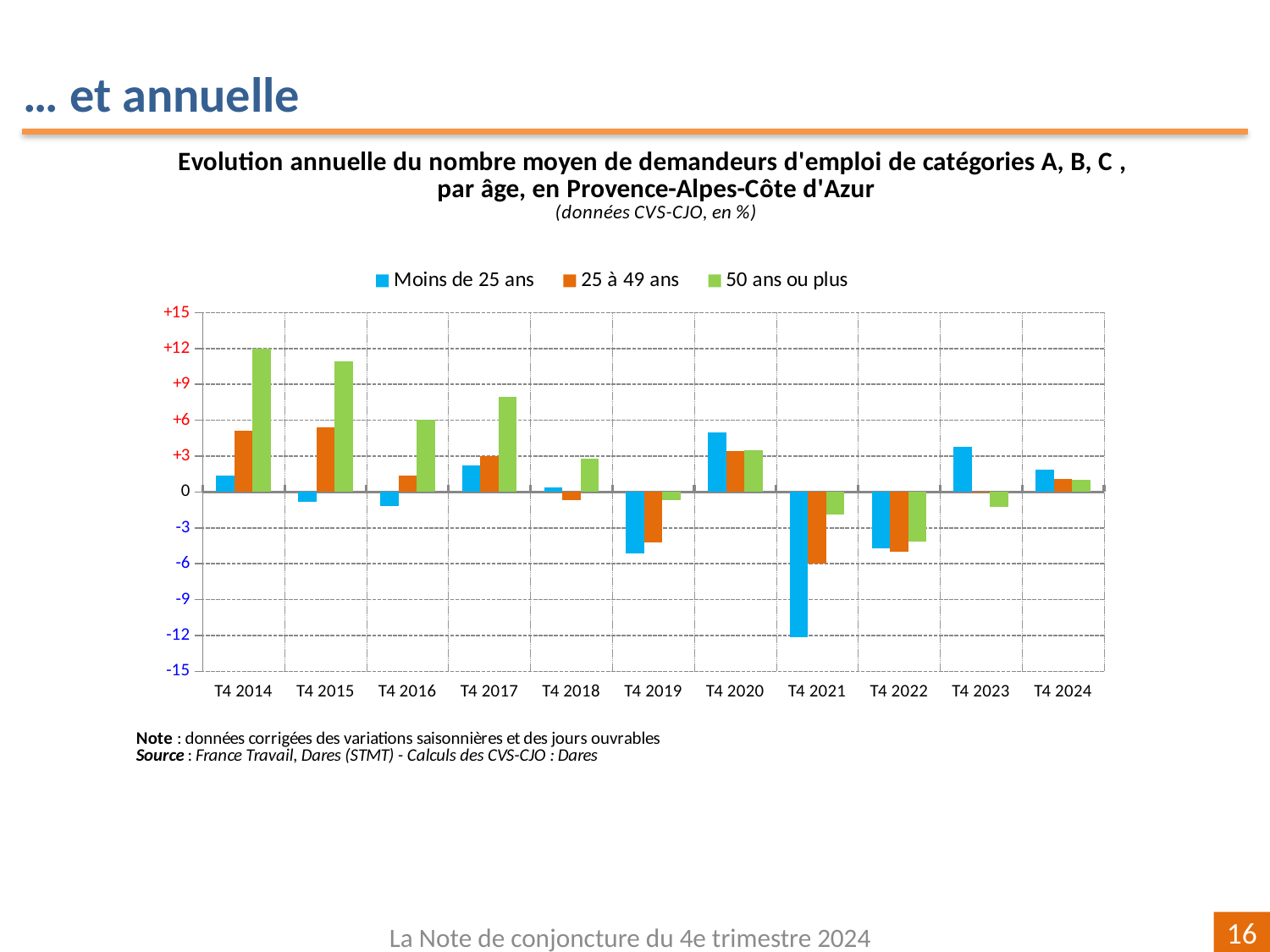
Does the value for '50 ans ou plus' rise or fall from T4 2014 to T4 2019? fall How many quarters (categories) are shown on the x axis? 11 In T4 2020, which is larger: the value for 'Moins de 25 ans' or for '25 à 49 ans'? Moins de 25 ans In T4 2014, which is larger: the value for '25 à 49 ans' or for '50 ans ou plus'? 50 ans ou plus Is the value for 'Moins de 25 ans' in T4 2021 greater or less than -9? less Which series are listed in the legend? Moins de 25 ans, 25 à 49 ans, 50 ans ou plus Is the value for '50 ans ou plus' in T4 2014 greater or less than +9? greater Is the value for '25 à 49 ans' in T4 2021 greater or less than -3? less How many series does the legend list? 3 What kind of chart is shown on the slide? bar chart In which quarter is the value for 'Moins de 25 ans' the lowest? T4 2021 In which quarter is the value for '50 ans ou plus' the highest? T4 2014